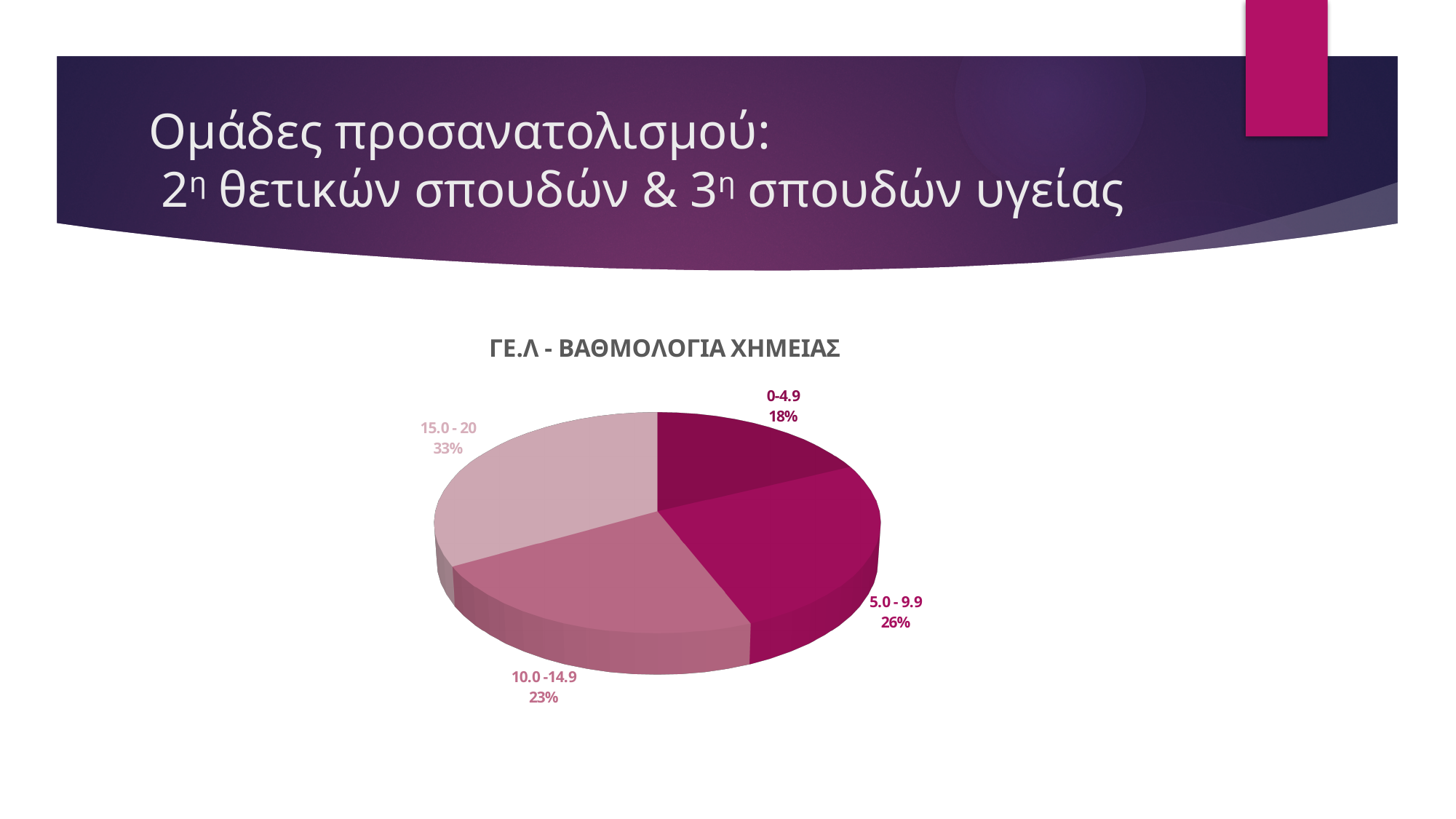
What percentage is shown for the 0-4.9 slice? 18% What type of chart is shown on the slide? pie chart Which is larger, the share for 5.0 - 9.9 or the share for 10.0 -14.9? 5.0 - 9.9 What is the difference in percentage points between the 15.0 - 20 slice and the 0-4.9 slice? 15 What is the combined share of the 0-4.9 and 5.0 - 9.9 slices? 44% What is the title of the chart? ΓΕ.Λ - ΒΑΘΜΟΛΟΓΙΑ ΧΗΜΕΙΑΣ Which grade range has the smallest share of the pie? 0-4.9 What percentage is shown for the 15.0 - 20 slice? 33% What percentage is shown for the 5.0 - 9.9 slice? 26% What percentage is shown for the 10.0 -14.9 slice? 23% How many slices does the pie chart have? 4 Which grade range has the largest share of the pie? 15.0 - 20